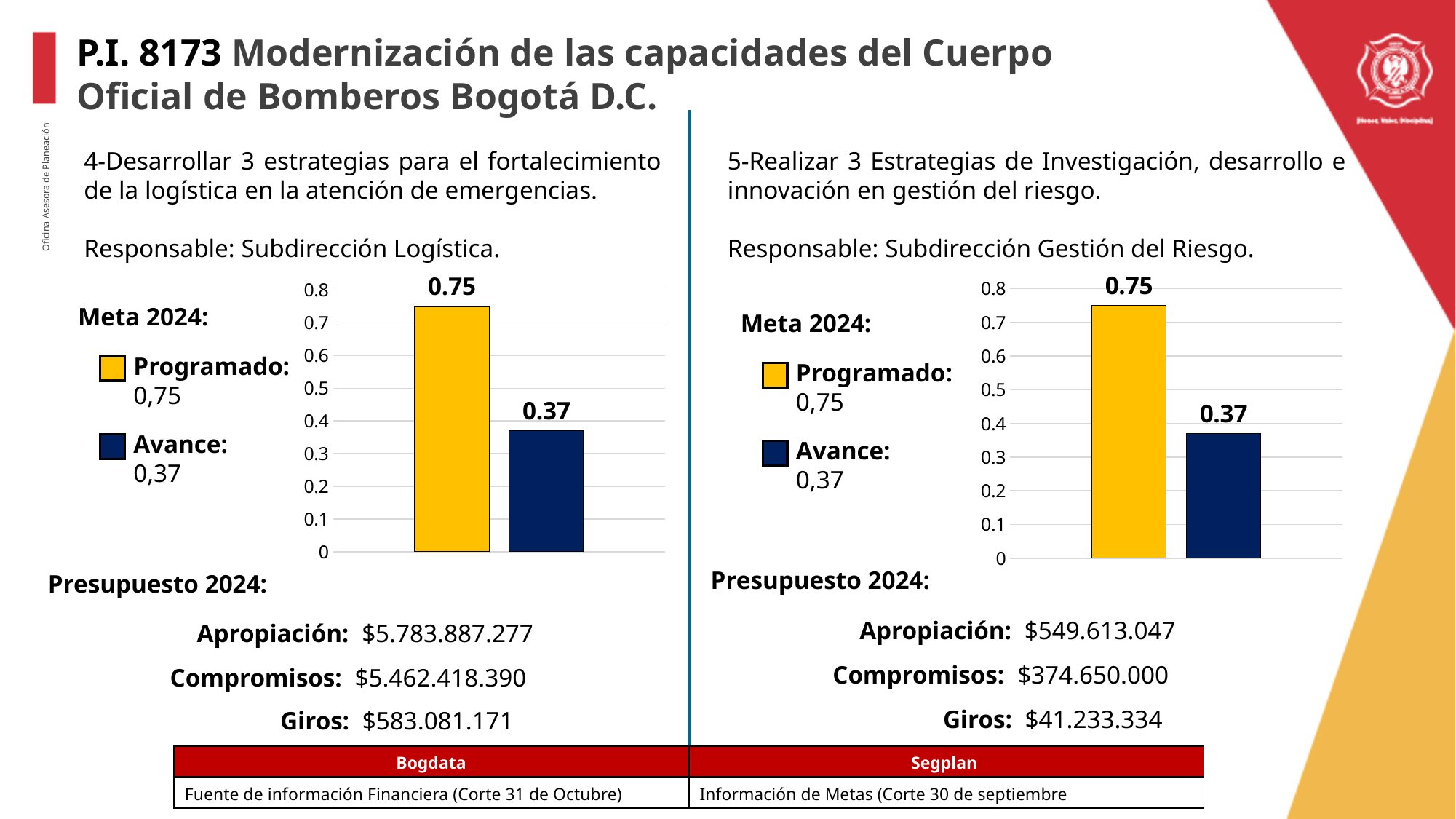
In the right chart, what is the difference between the Programado and Avance values? 0.38 In the left chart (goal 4, Subdirección Logística), what is the value of the Avance bar? 0.37 In the left chart (goal 4, Subdirección Logística), what is the value of the Programado bar? 0.75 In the left chart, which bar is higher, Programado or Avance? Programado What type of chart is shown on the left side of the slide? Bar chart In the left chart, what is the difference between the Programado and Avance values? 0.38 In the right chart, which bar is the lowest? Avance In the left chart, is the Avance value greater or less than 0.4? less In the right chart (goal 5, Subdirección Gestión del Riesgo), what is the value of the Programado bar? 0.75 In the right chart (goal 5, Subdirección Gestión del Riesgo), what is the value of the Avance bar? 0.37 In the right chart, what colour is the Programado bar? Yellow How many bars are plotted in the right chart? 2